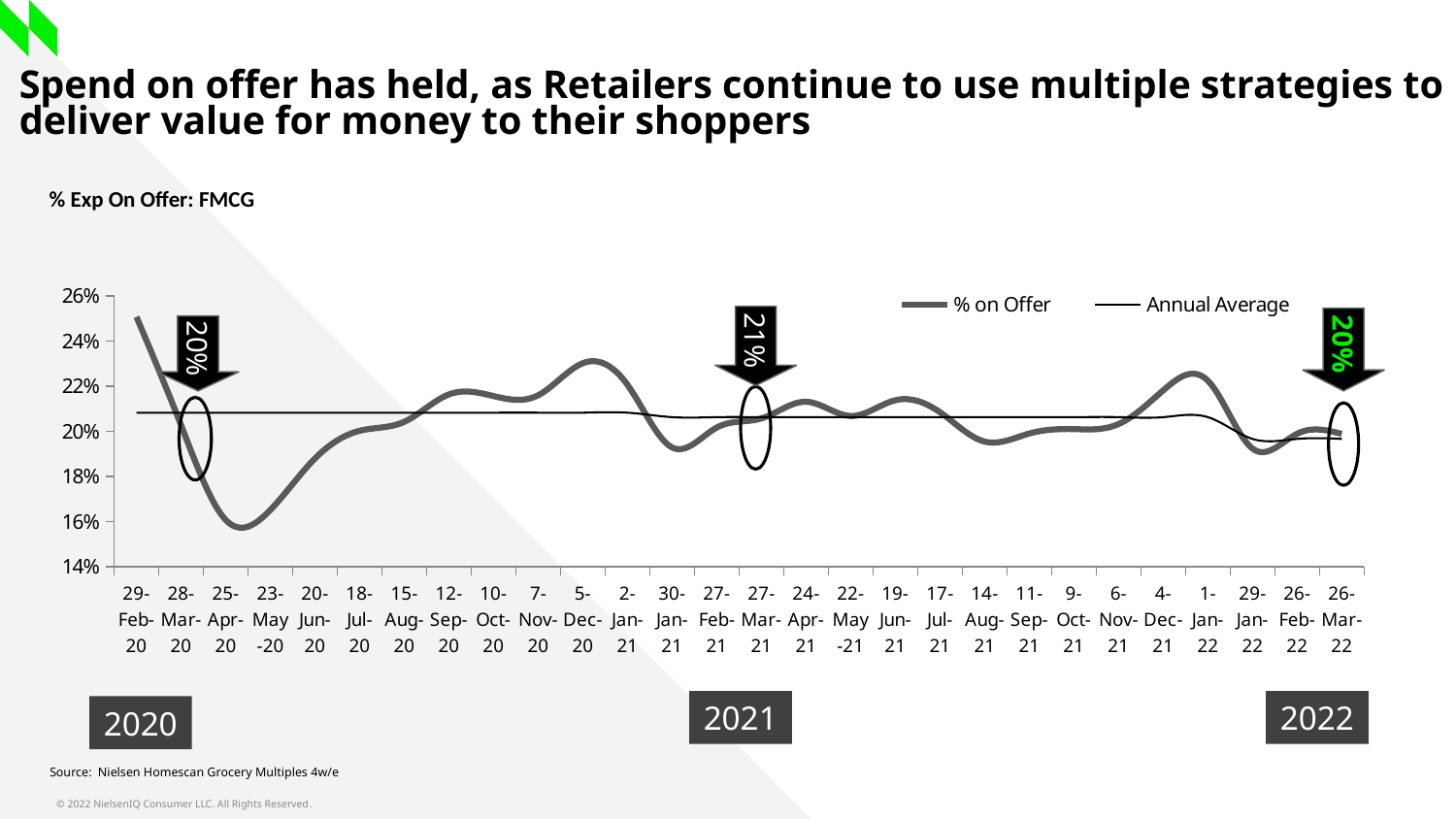
How many series does the legend list? 2 Is the % on Offer value for 25-Apr-20 greater or less than 18%? less At which date does the % on Offer line reach its highest point? 29-Feb-20 What type of chart is shown on the slide? Line chart What are the two series named in the legend? % on Offer and Annual Average Is the % on Offer value for 5-Dec-20 greater or less than 22%? greater How many dates are shown along the x axis? 28 What annual average value is annotated for 2022? 20% What annual average value is annotated for 2021? 21% Does the % on Offer line rise or fall between 29-Feb-20 and 25-Apr-20? fall At which date does the % on Offer line reach its lowest point? 25-Apr-20 What is the title of the chart? % Exp On Offer: FMCG